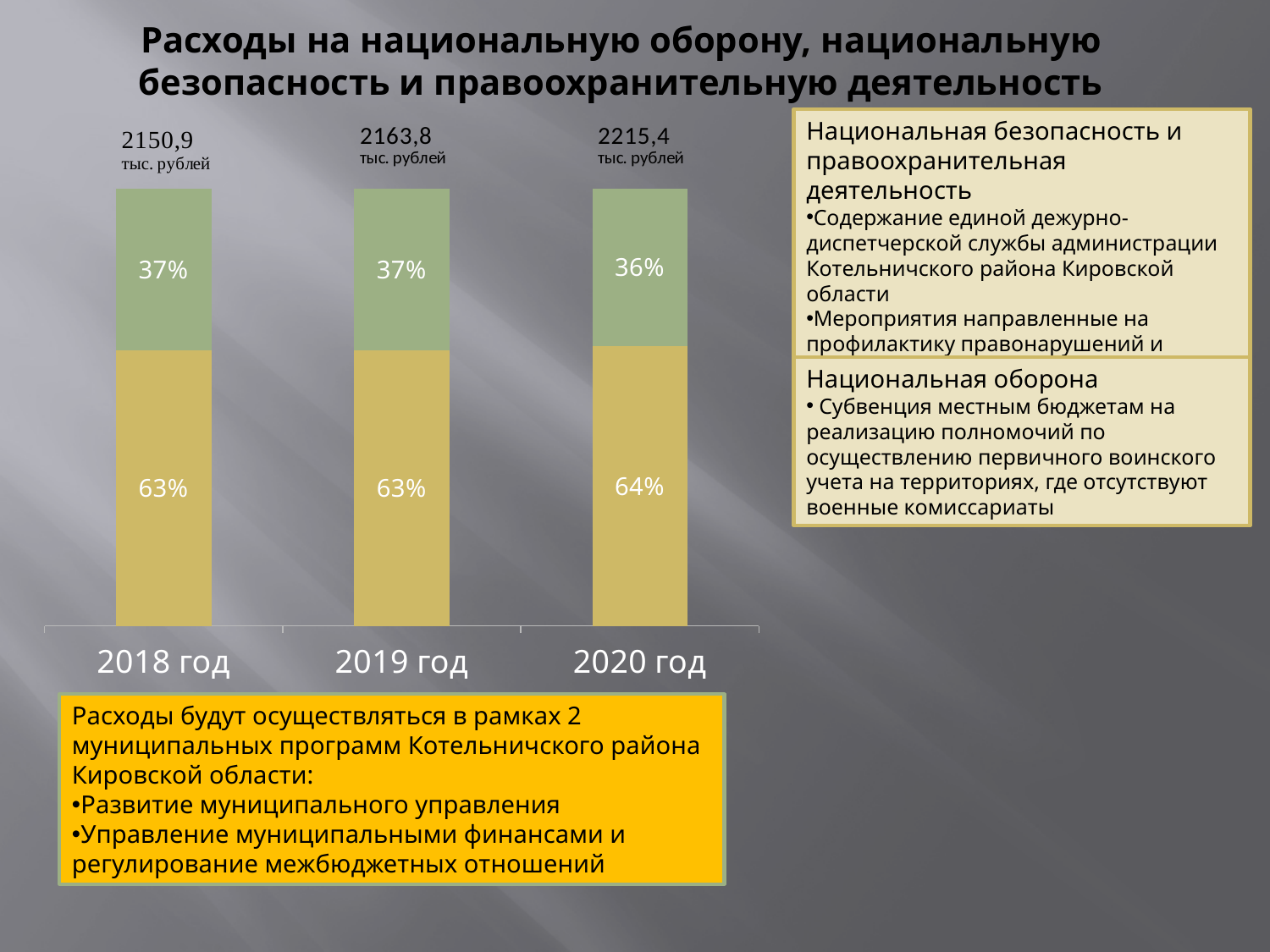
Which year has the lowest total value printed above its bar? 2018 год What percentage is shown in the lower (yellow) segment of the bar for 2020 год? 64% What is the difference between the total values printed for 2020 год and 2018 год? 64,5 тыс. рублей What kind of chart is shown on the slide? Stacked bar chart Which year has the highest total value printed above its bar? 2020 год Do the total values printed above the bars rise or fall from 2018 год to 2020 год? Rise What is the title of the chart on the slide? Расходы на национальную оборону, национальную безопасность и правоохранительную деятельность What percentage is shown in the upper (green) segment of the bar for 2019 год? 37% How many years (categories) are shown on the x axis of the chart? 3 What total value is printed above the bar for 2020 год? 2215,4 тыс. рублей Which year has the larger upper (green) segment percentage, 2018 год or 2020 год? 2018 год What total value is printed above the bar for 2018 год? 2150,9 тыс. рублей